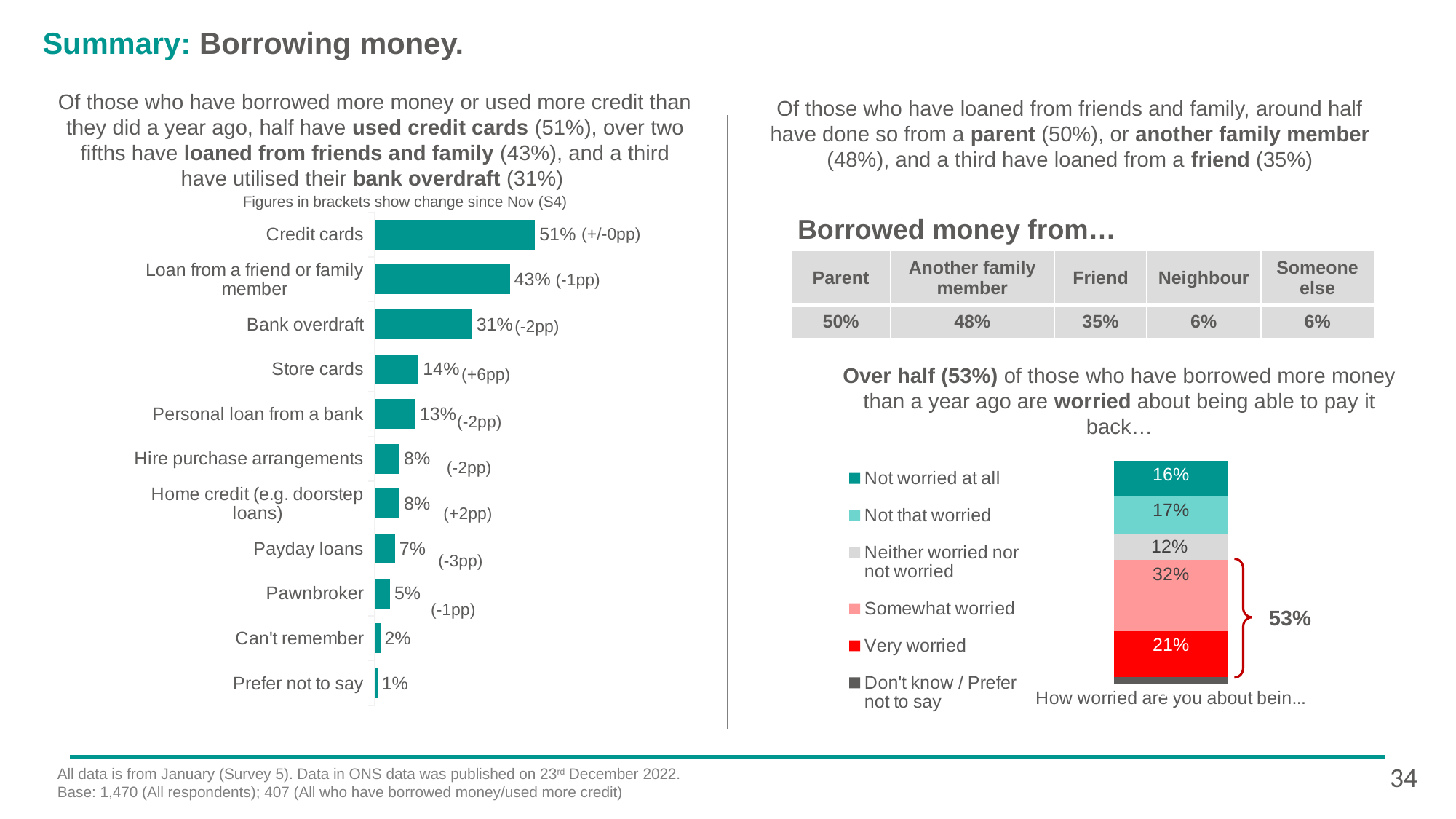
In the left bar chart, which category has the lowest value? Prefer not to say In the left bar chart, which category has the highest value? Credit cards In the left bar chart, what percentage is shown for Bank overdraft? 31% What type of chart is the left chart on the slide? Bar chart In the stacked bar chart on the right, what is the combined share of Somewhat worried and Very worried? 53% In the left bar chart, what percentage is shown for Credit cards? 51% In the left bar chart, which is larger: Store cards or Personal loan from a bank? Store cards In the left bar chart, what change since Nov is shown in brackets for Store cards? +6pp In the left bar chart, what is the difference between Credit cards and Loan from a friend or family member? 8 percentage points In the stacked bar chart on the right, what percentage is shown for Somewhat worried? 32% How many categories are shown in the left bar chart? 11 How many entries does the legend of the stacked bar chart on the right list? 6